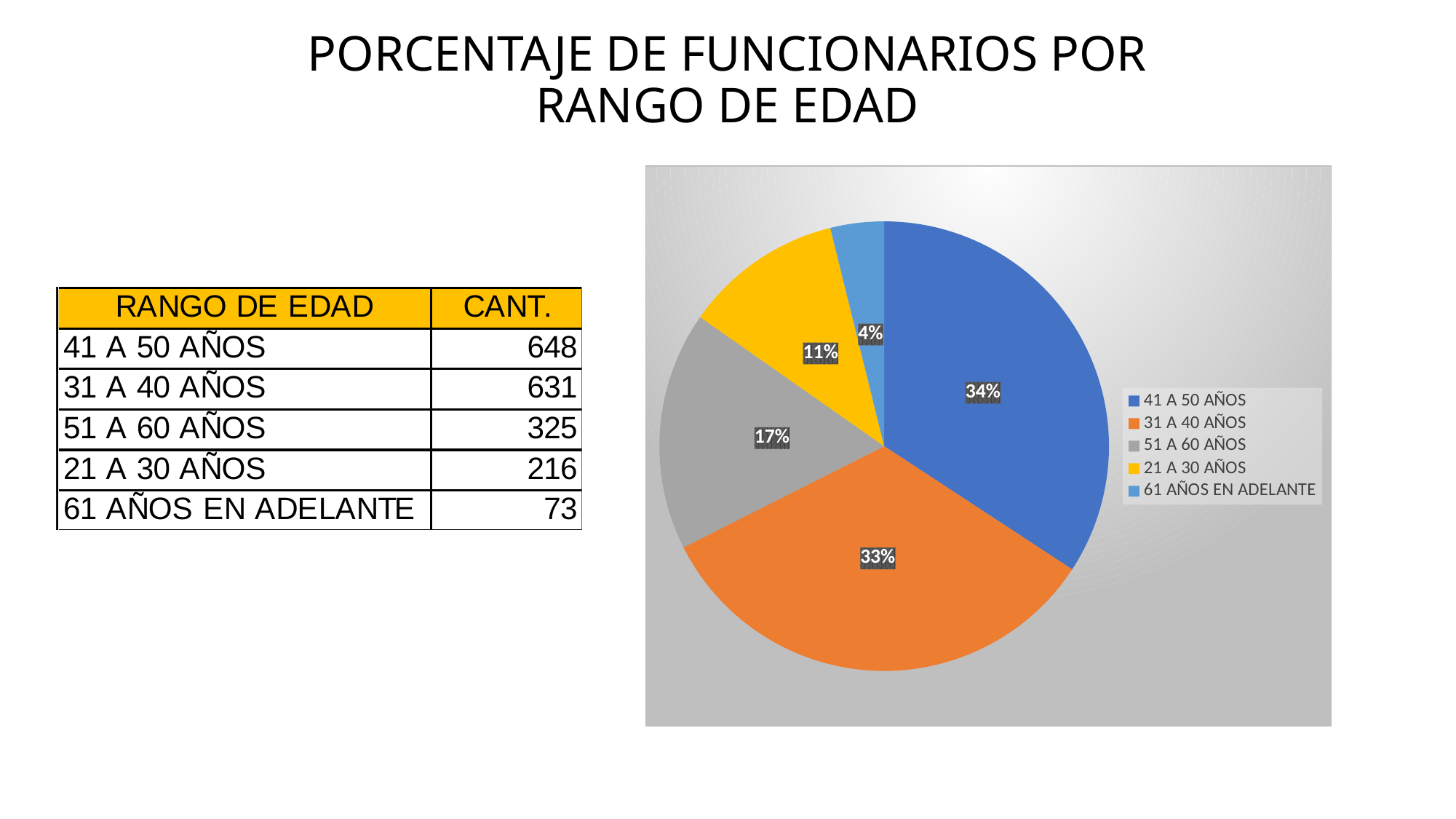
What kind of chart is shown on the slide? Pie chart How many slices does the pie chart have? 5 What is the difference in percentage points between the 51 A 60 AÑOS slice and the 21 A 30 AÑOS slice? 6% Which age range has the largest slice of the pie? 41 A 50 AÑOS Which slice is larger, 51 A 60 AÑOS or 21 A 30 AÑOS? 51 A 60 AÑOS What share of the pie does the 31 A 40 AÑOS slice represent? 33% What share of the pie does the 61 AÑOS EN ADELANTE slice represent? 4% What colour is the slice for 21 A 30 AÑOS? Yellow What share of the pie does the 21 A 30 AÑOS slice represent? 11% Which age range has the smallest slice of the pie? 61 AÑOS EN ADELANTE